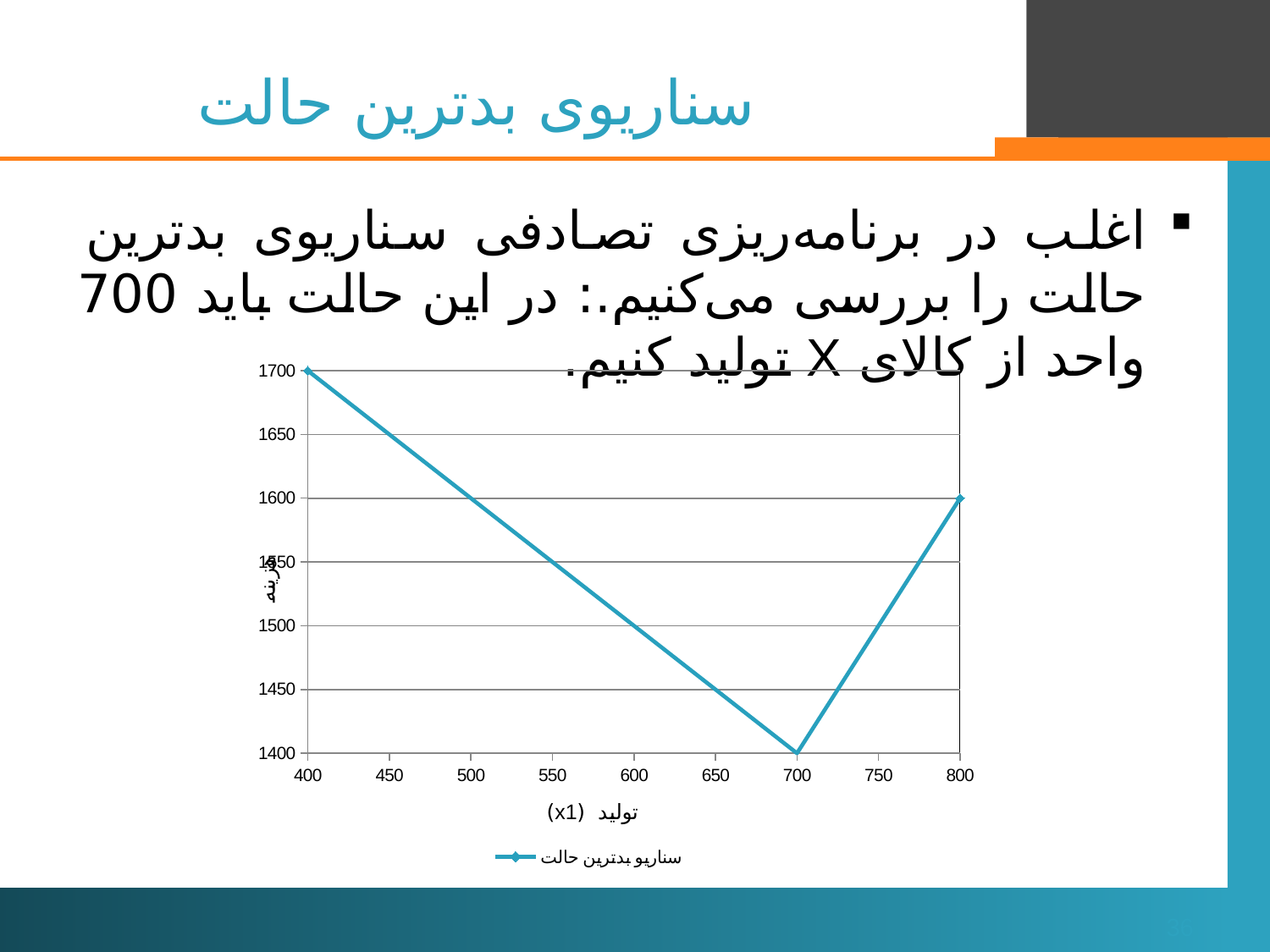
What is the difference between the value at x = 400 and the value at x = 700? 300 What is the value of the line at x = 400? 1700 At which x value does the line reach its highest point? 400 What is the value of the line at x = 800? 1600 How many series does the legend list? 1 What is the difference between the value at x = 800 and the value at x = 700? 200 At which x value does the line reach its lowest point? 700 What kind of chart is shown on the slide? line chart What is the value of the line at x = 700? 1400 Is the value of the line at x = 450 greater or less than 1600? greater Which is larger, the value at x = 400 or the value at x = 800? x = 400 Does the line rise or fall as x goes from 400 to 700? fall